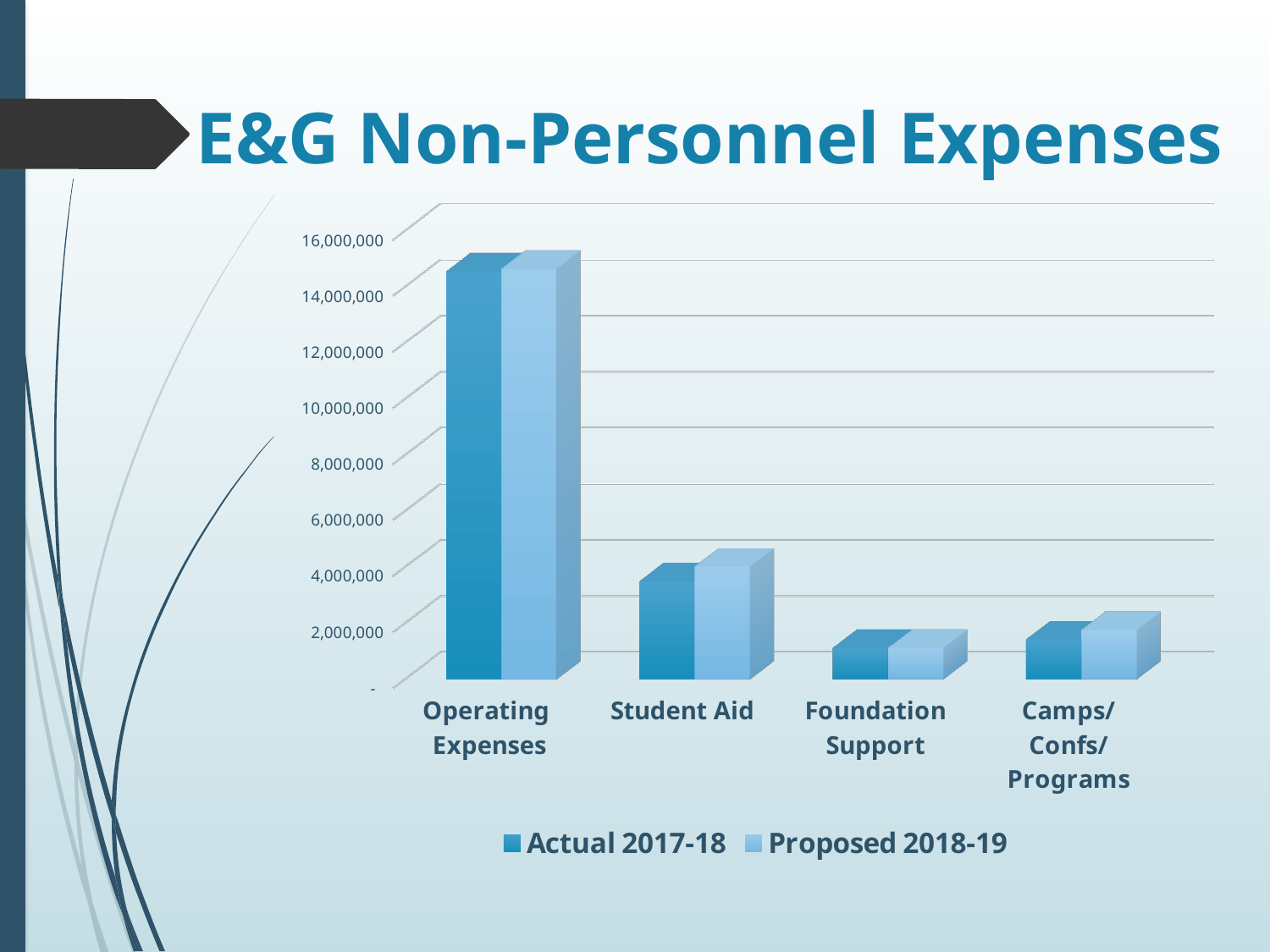
Is the Proposed 2018-19 value for Student Aid greater or less than 6,000,000? less Which is larger, the Actual 2017-18 value for Student Aid or the Actual 2017-18 value for Camps/Confs/Programs? Student Aid Is the Actual 2017-18 value for Operating Expenses greater or less than 12,000,000? greater How many series does the legend list? 2 What is the title of the chart? E&G Non-Personnel Expenses How many expense categories are shown on the x axis? 4 What type of chart is shown on the slide? Bar chart Which category has the lowest values? Foundation Support What are the two series named in the legend? Actual 2017-18 and Proposed 2018-19 Which category has the highest values? Operating Expenses Is the Actual 2017-18 value for Foundation Support greater or less than 2,000,000? less Which is larger, the Proposed 2018-19 value for Operating Expenses or the Proposed 2018-19 value for Student Aid? Operating Expenses